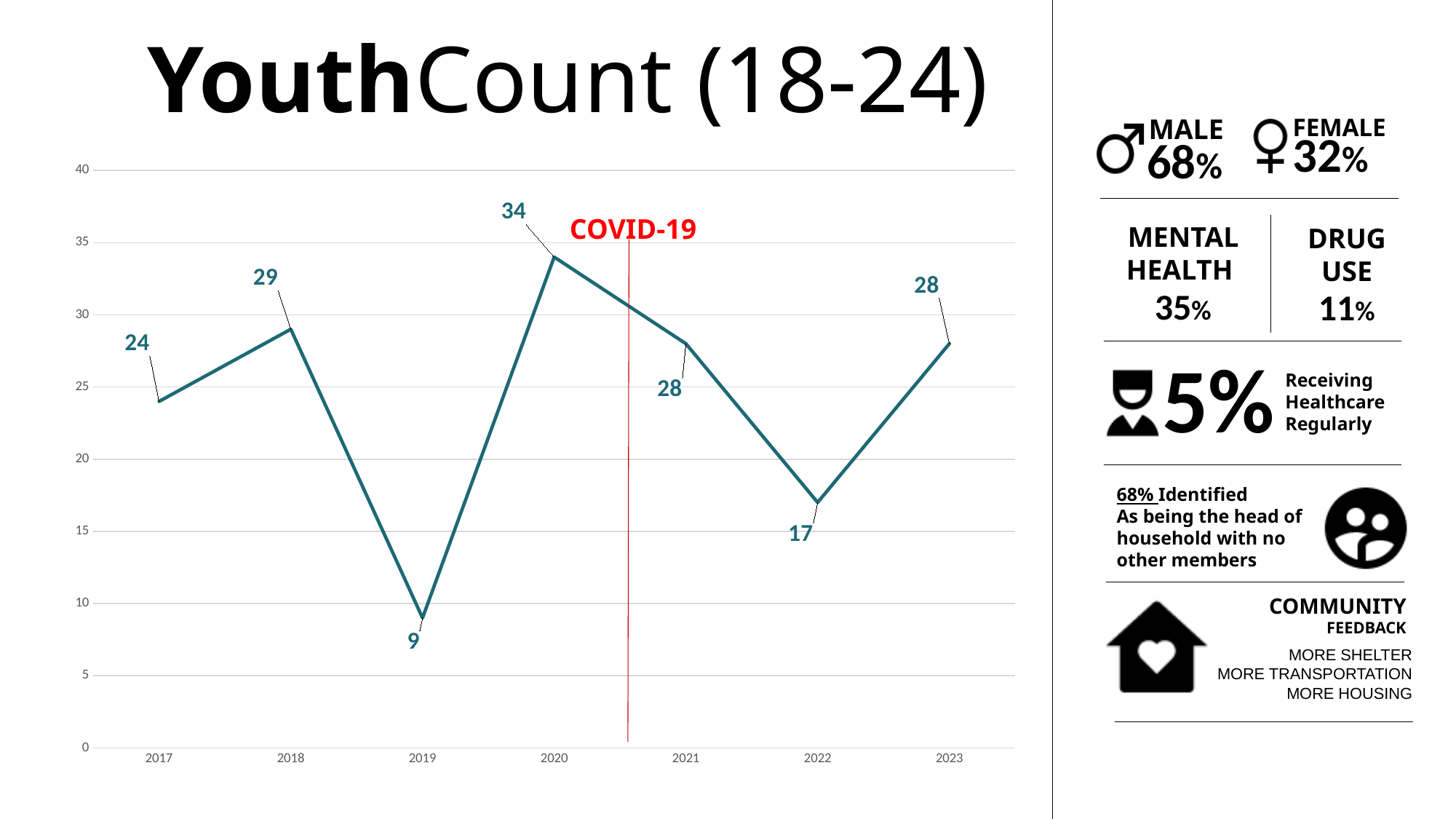
What is the youth count value for 2020? 34 What is the youth count value for 2022? 17 What label is written next to the red vertical line on the chart? COVID-19 What is the difference between the youth count in 2020 and in 2019? 25 What kind of chart is shown on the slide? line chart What is the difference between the youth count in 2018 and in 2017? 5 Which year has a larger youth count, 2017 or 2018? 2018 Is the youth count for 2022 greater or less than 20? less How many years are plotted on the chart? 7 Which year has the highest youth count? 2020 Which year has the lowest youth count? 2019 What is the youth count value for 2019? 9